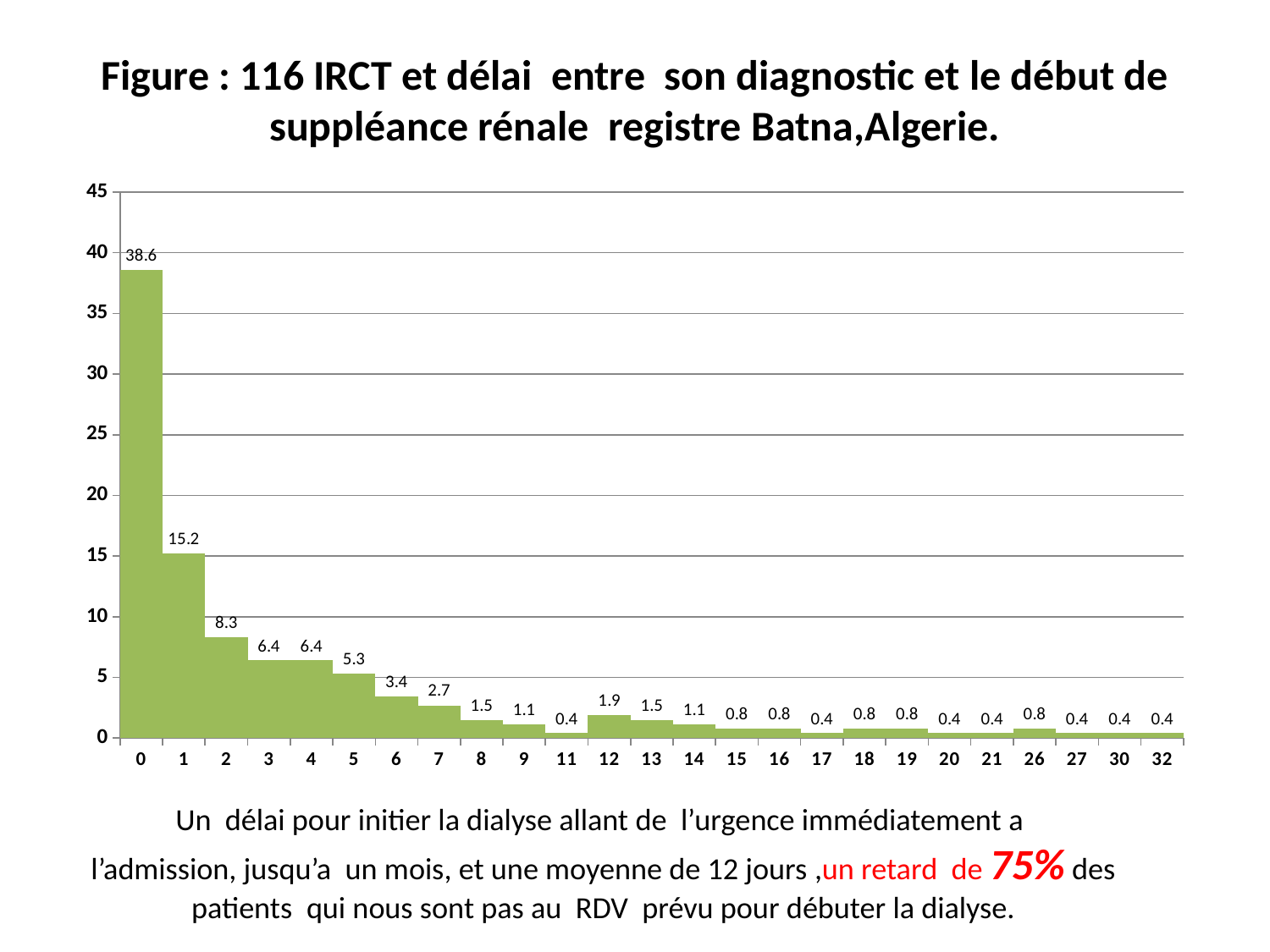
What is the value for category 12? 1.9 Which category has the highest value? 0 What is the value for category 1? 15.2 Which is larger, the value for category 6 or the value for category 12? category 6 What is the value for category 5? 5.3 Is the value for category 1 greater or less than 20? less What is the difference between the values for category 2 and category 3? 1.9 How many categories are shown on the x axis? 25 What type of chart is shown on the slide? bar chart What is the value for category 0? 38.6 What is the difference between the values for category 0 and category 1? 23.4 Do the values generally rise or fall from category 0 to category 9? fall